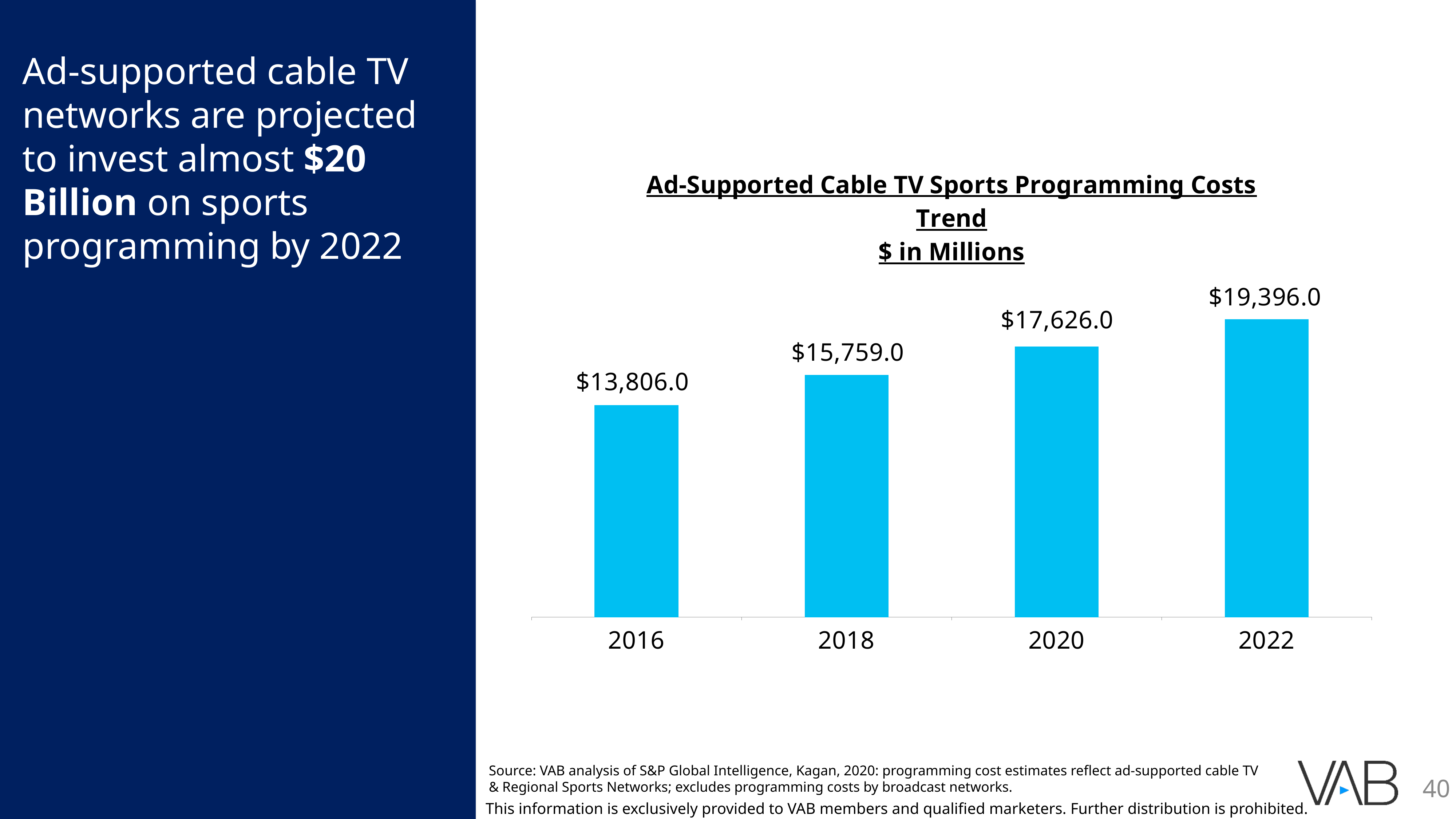
Which is larger, the value for 2018 or the value for 2020? 2020 What is the value for 2016? $13,806.0 What kind of chart is shown? Bar chart What is the difference between the values for 2020 and 2018? $1,867.0 How many years are shown on the x axis? 4 Do the values rise or fall from 2016 to 2022? Rise Which year has the highest value? 2022 What is the value for 2022? $19,396.0 What is the difference between the values for 2022 and 2016? $5,590.0 What is the value for 2018? $15,759.0 What is the value for 2020? $17,626.0 Which year has the lowest value? 2016